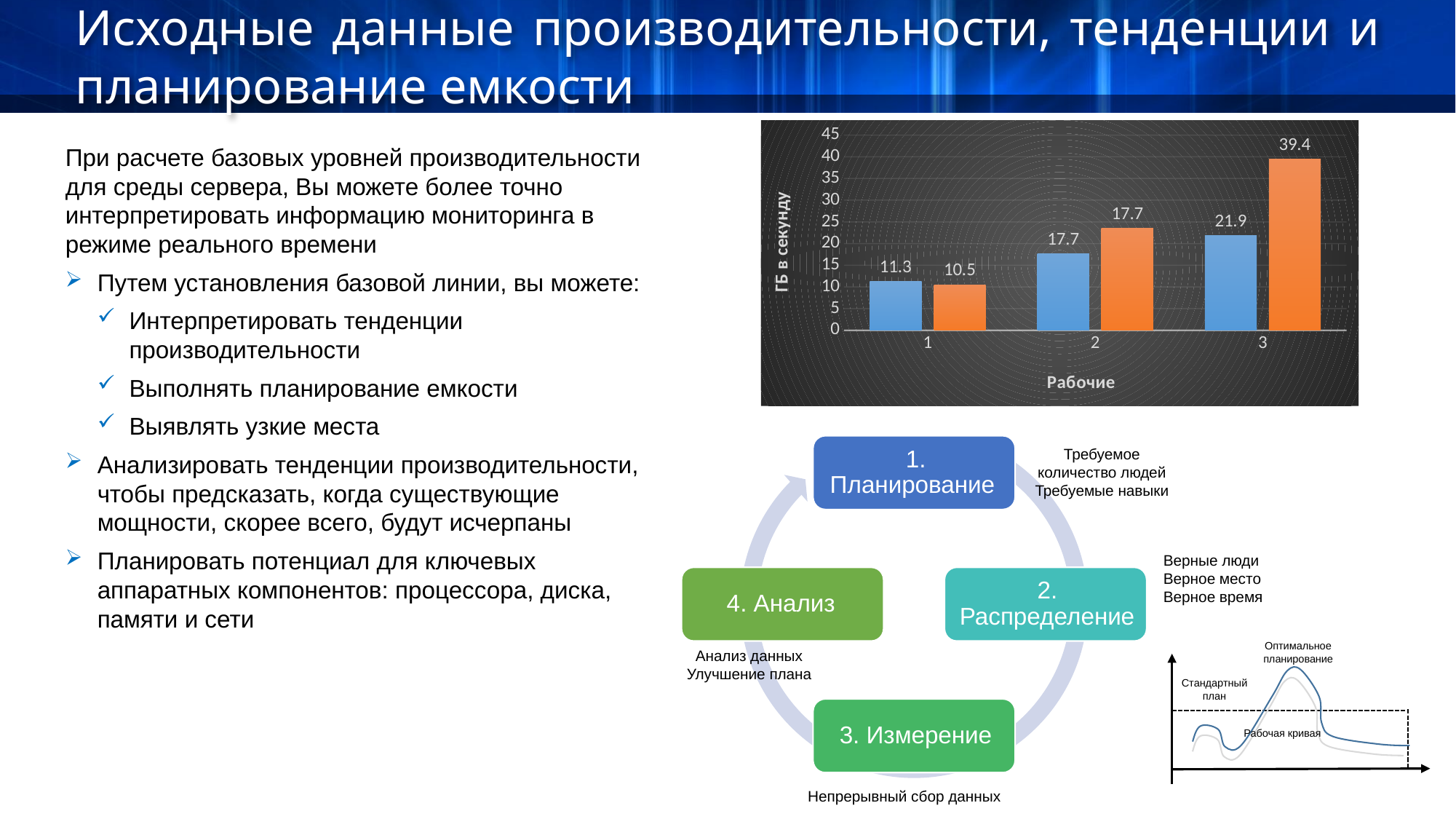
In the bar chart, which is larger for category 1: the blue bar or the orange bar? blue bar In the bar chart, what is the value of the orange bar for category 3? 39.4 In the bar chart, which category has the highest orange bar? 3 How many categories are shown on the x axis of the bar chart? 3 In the bar chart, what is the difference between the orange and blue bars for category 3? 17.5 What type of chart is shown in the top right of the slide? bar chart In the bar chart, which category has the lowest blue bar? 1 What is the label of the y axis of the bar chart? ГБ в секунду In the bar chart, what is the value of the blue bar for category 3? 21.9 In the bar chart, what is the value of the blue bar for category 1? 11.3 In the bar chart, what is the value of the orange bar for category 1? 10.5 Do the values of the blue bars rise or fall from category 1 to category 3? rise